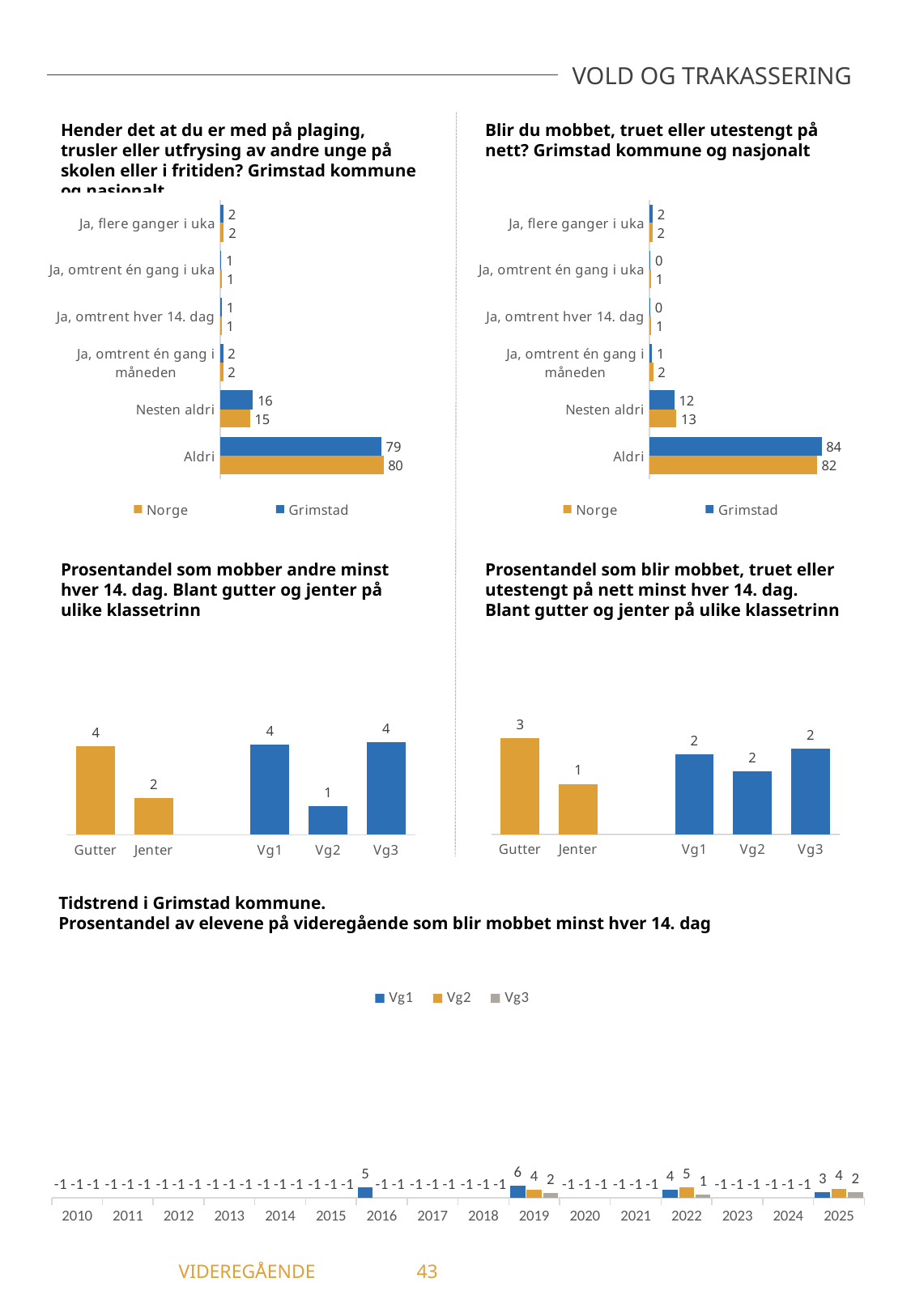
In the chart 'Prosentandel som mobber andre minst hver 14. dag', which category has the lowest value? Vg2 In the chart 'Hender det at du er med på plaging, trusler eller utfrysing av andre unge på skolen eller i fritiden?', what is the value for Norge in the 'Aldri' category? 80 In the chart 'Prosentandel som blir mobbet, truet eller utestengt på nett minst hver 14. dag', which is larger, the value for Gutter or the value for Jenter? Gutter In the chart 'Tidstrend i Grimstad kommune', what is the value for Vg2 in 2022? 5 What kind of chart is 'Blir du mobbet, truet eller utestengt på nett?'? Bar chart In the chart 'Blir du mobbet, truet eller utestengt på nett?', what is the value for Grimstad in the 'Aldri' category? 84 In the chart 'Hender det at du er med på plaging, trusler eller utfrysing av andre unge på skolen eller i fritiden?', what is the value for Grimstad in the 'Nesten aldri' category? 16 In the chart 'Blir du mobbet, truet eller utestengt på nett?', what is the difference between the Norge and Grimstad values for 'Nesten aldri'? 1 In the chart 'Prosentandel som mobber andre minst hver 14. dag', what is the value for Jenter? 2 In the chart 'Hender det at du er med på plaging, trusler eller utfrysing av andre unge på skolen eller i fritiden?', how many series does the legend list? 2 In the chart 'Blir du mobbet, truet eller utestengt på nett?', which category has the highest value for Grimstad? Aldri In the chart 'Tidstrend i Grimstad kommune', how many years are shown on the x axis? 16